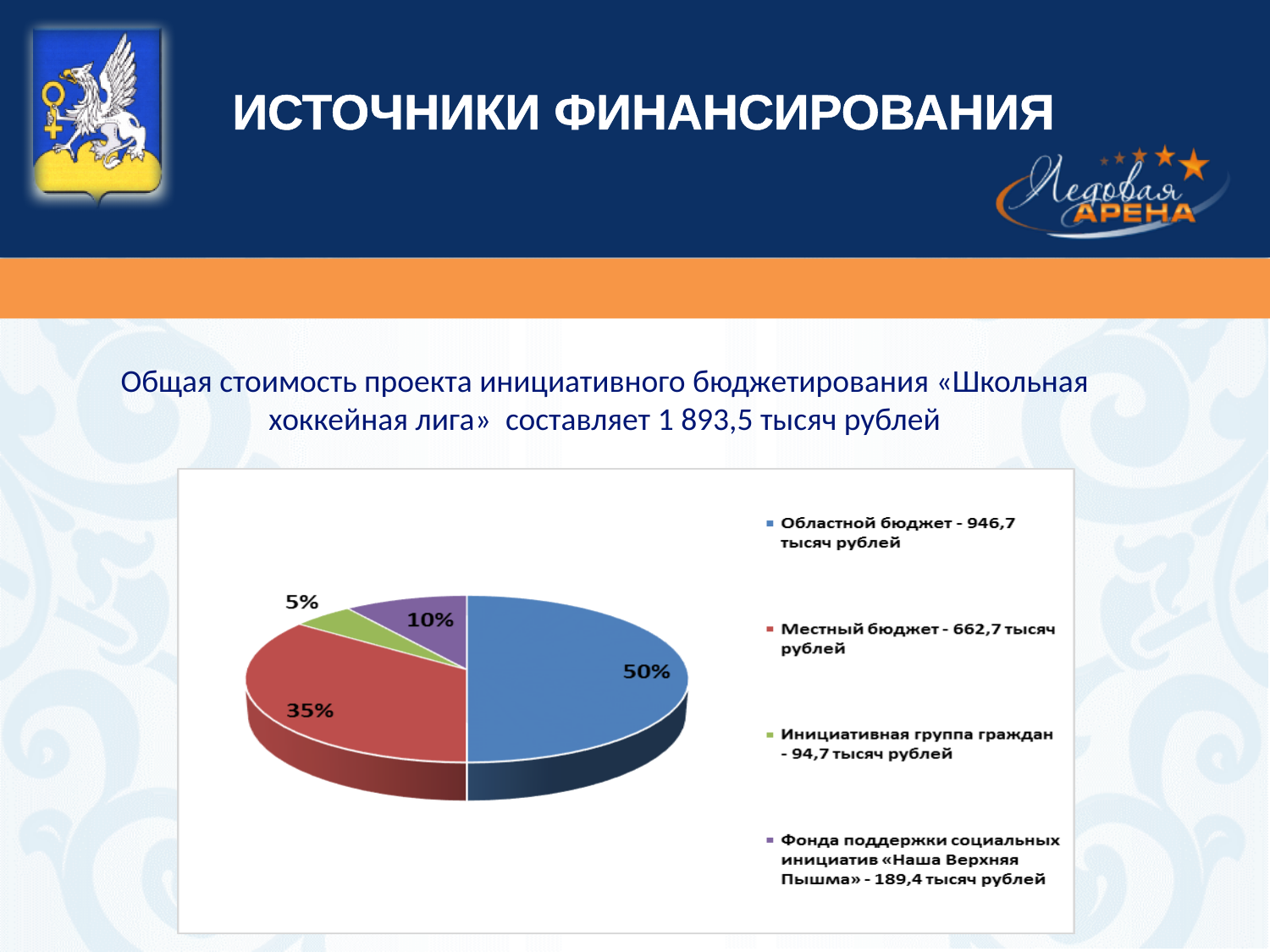
Which funding source has the largest share of the pie? Областной бюджет Which is larger: the share of the «Наша Верхняя Пышма» fund or the share of the citizens' initiative group? Фонда поддержки социальных инициатив «Наша Верхняя Пышма» What kind of chart is shown on the slide? pie chart What share of the pie does the citizens' initiative group (Инициативная группа граждан) slice represent? 5% According to the legend, how many thousand rubles come from the local budget (Местный бюджет)? 662,7 тысяч рублей Which funding source has the smallest share of the pie? Инициативная группа граждан How many slices does the pie chart have? 4 What share of the pie does the «Наша Верхняя Пышма» social initiatives support fund slice represent? 10% What is the difference in percentage points between the regional budget share and the local budget share? 15% What share of the pie does the regional budget (Областной бюджет) slice represent? 50% What colour is the slice for the regional budget (Областной бюджет)? blue